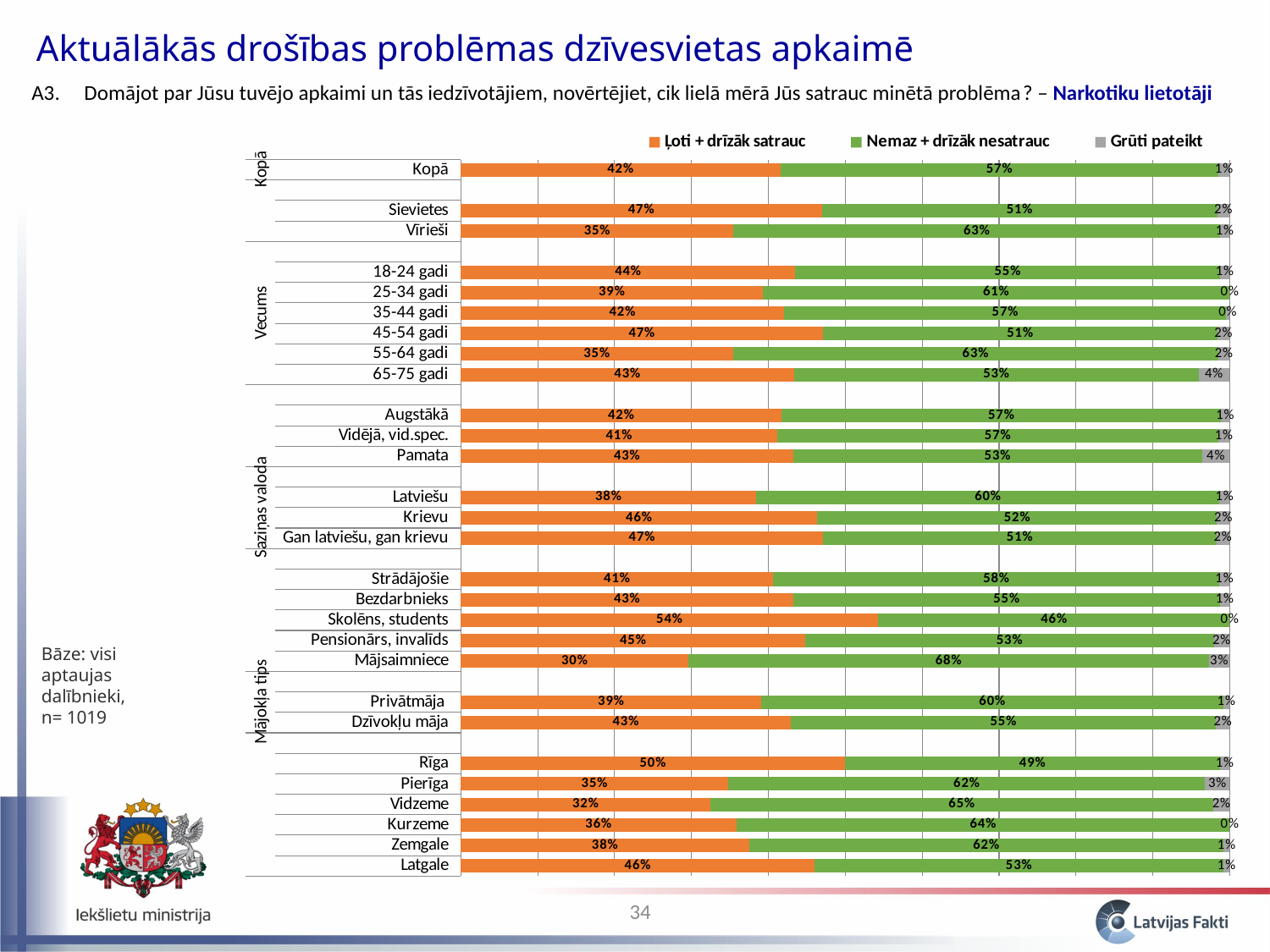
What is the value of "Ļoti + drīzāk satrauc" for Mājsaimniece? 30% What colour represents "Grūti pateikt" in the legend? Grey What is the value of "Ļoti + drīzāk satrauc" for Kopā? 42% What kind of chart is shown on the slide? Stacked bar chart What is the total of the stacked bar for Kopā? 100% Which category has the highest value for "Ļoti + drīzāk satrauc"? Skolēns, students Which category has the lowest value for "Ļoti + drīzāk satrauc"? Mājsaimniece How many series does the legend list? 3 What is the value of "Grūti pateikt" for 65-75 gadi? 4% What is the value of "Nemaz + drīzāk nesatrauc" for Skolēns, students? 46% What is the difference in "Ļoti + drīzāk satrauc" between Sievietes and Vīrieši? 12 percentage points Which has a larger "Ļoti + drīzāk satrauc" value, Rīga or Latgale? Rīga